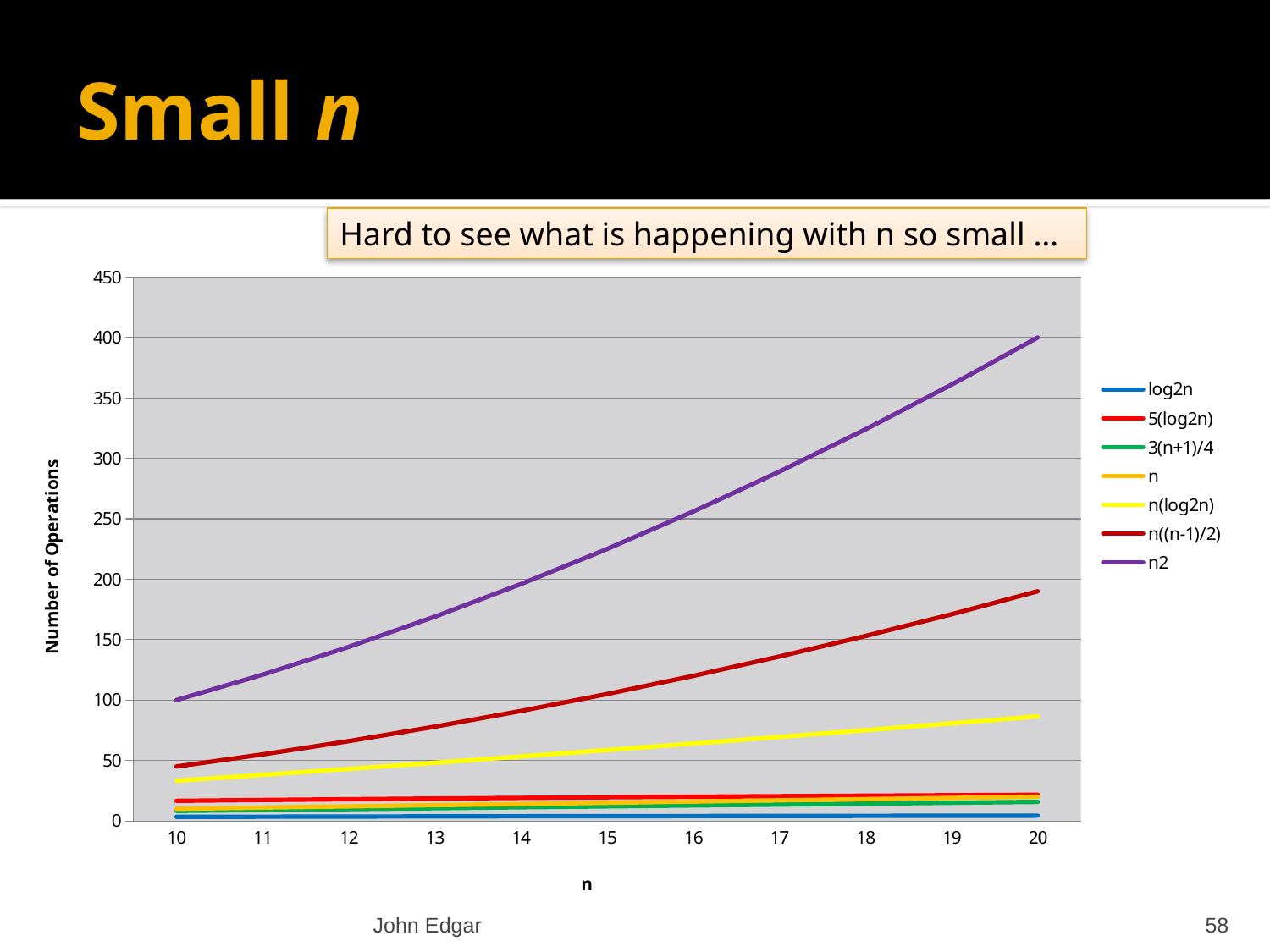
Which series has the highest value at n = 20? n2 Is the value of n((n-1)/2) at n = 20 greater or less than 150? greater Which series has the lowest values across the chart? log2n What is the value of the n2 series at n = 20? 400 How many series does the legend list? 7 Is the value of n(log2n) at n = 20 greater or less than 100? less What is the title of the y axis? Number of Operations What is the value of the n2 series at n = 10? 100 Does the n2 series rise or fall as n increases from 10 to 20? rise How many values of n are marked along the x axis? 11 What kind of chart is shown on the slide? line chart By how much does the n2 series increase from n = 10 to n = 20? 300